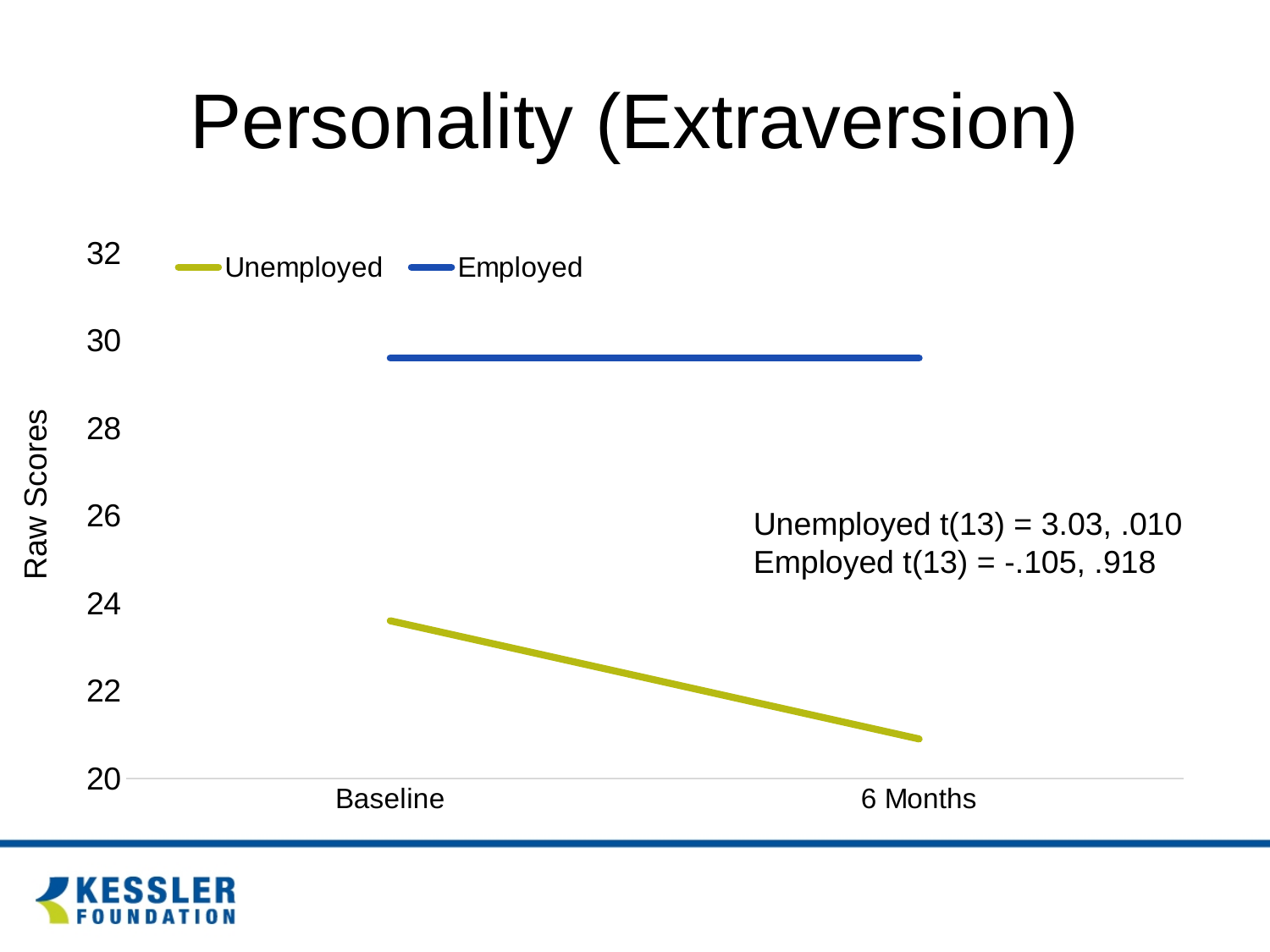
Which series has the lower value at Baseline? Unemployed Is the Unemployed value at Baseline greater or less than 24? less Which series has the higher value at 6 Months, Unemployed or Employed? Employed Does the Unemployed line rise or fall from Baseline to 6 Months? fall Is the Employed value at 6 Months greater or less than 30? less Is the Employed value at Baseline greater or less than 28? greater What kind of chart is shown on the slide? line chart What is the label on the y axis? Raw Scores How many points are on the x axis? 2 How many series does the legend list? 2 What is the title of the slide? Personality (Extraversion)